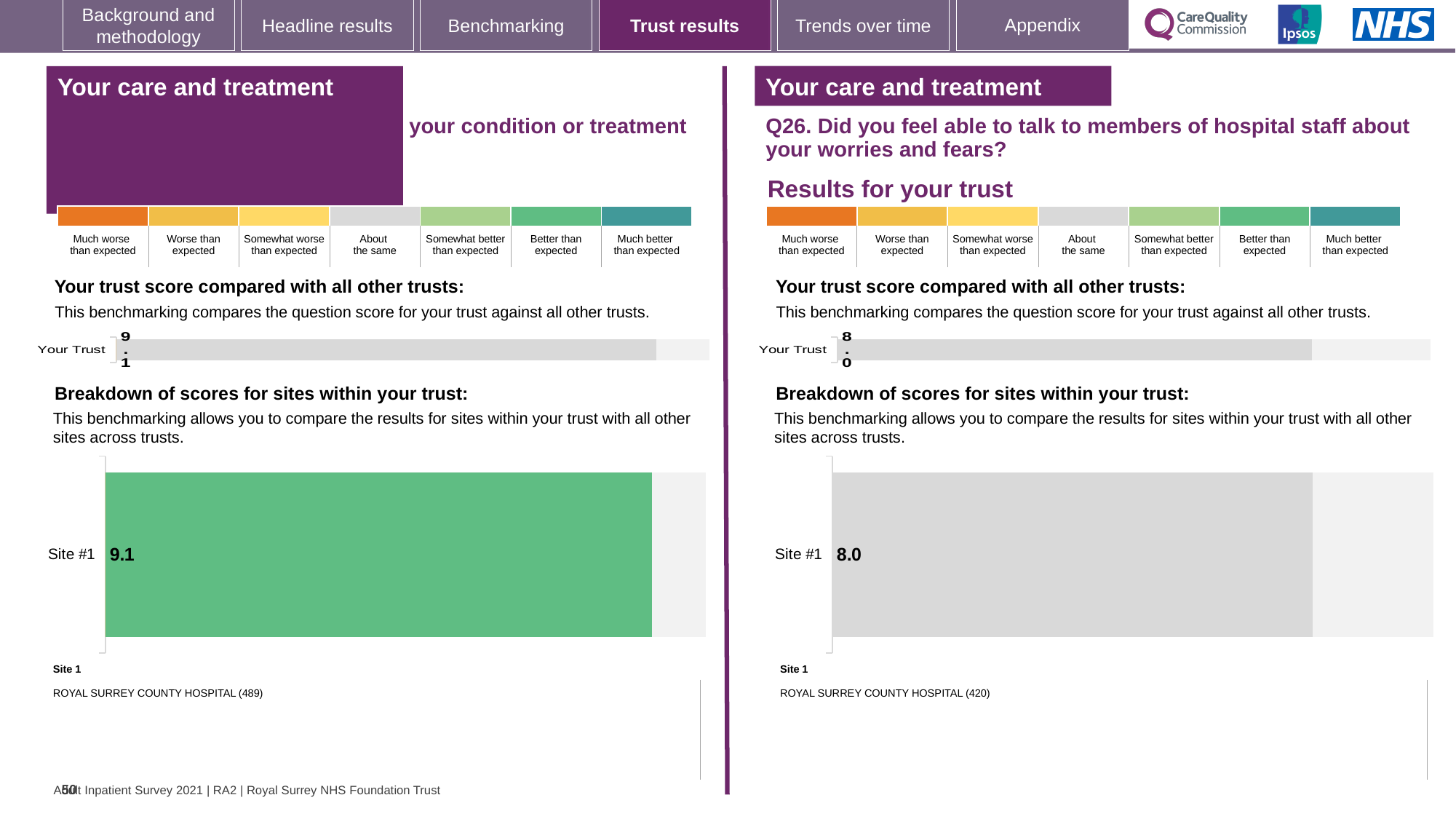
What colour is the Site #1 bar in the left-hand breakdown chart? Green How many sites are plotted in the left-hand 'Breakdown of scores for sites within your trust' chart? 1 What colour is the Site #1 bar in the right-hand breakdown chart for Q26? Grey In the left-hand 'Breakdown of scores for sites within your trust' chart, what is the value for Site #1? 9.1 What type of chart is used to show the Site #1 score in the left-hand 'Breakdown of scores for sites within your trust' section? Bar chart What is the difference between the Site #1 score in the left-hand breakdown chart (9.1) and the Site #1 score in the right-hand breakdown chart (8.0)? 1.1 On the left half of the slide, what is the score shown for Your Trust in the 'Your trust score compared with all other trusts' chart? 9.1 How many sites are plotted in the right-hand 'Breakdown of scores for sites within your trust' chart? 1 In the right-hand 'Breakdown of scores for sites within your trust' chart for Q26, what is the value for Site #1? 8.0 Which is larger: the Site #1 score in the left-hand breakdown chart or the Site #1 score in the right-hand breakdown chart? The left-hand chart (9.1) On the right half of the slide (Q26), what is the score shown for Your Trust in the 'Your trust score compared with all other trusts' chart? 8.0 Is the Your Trust score in the right-hand (Q26) chart greater or less than the Your Trust score in the left-hand chart? less